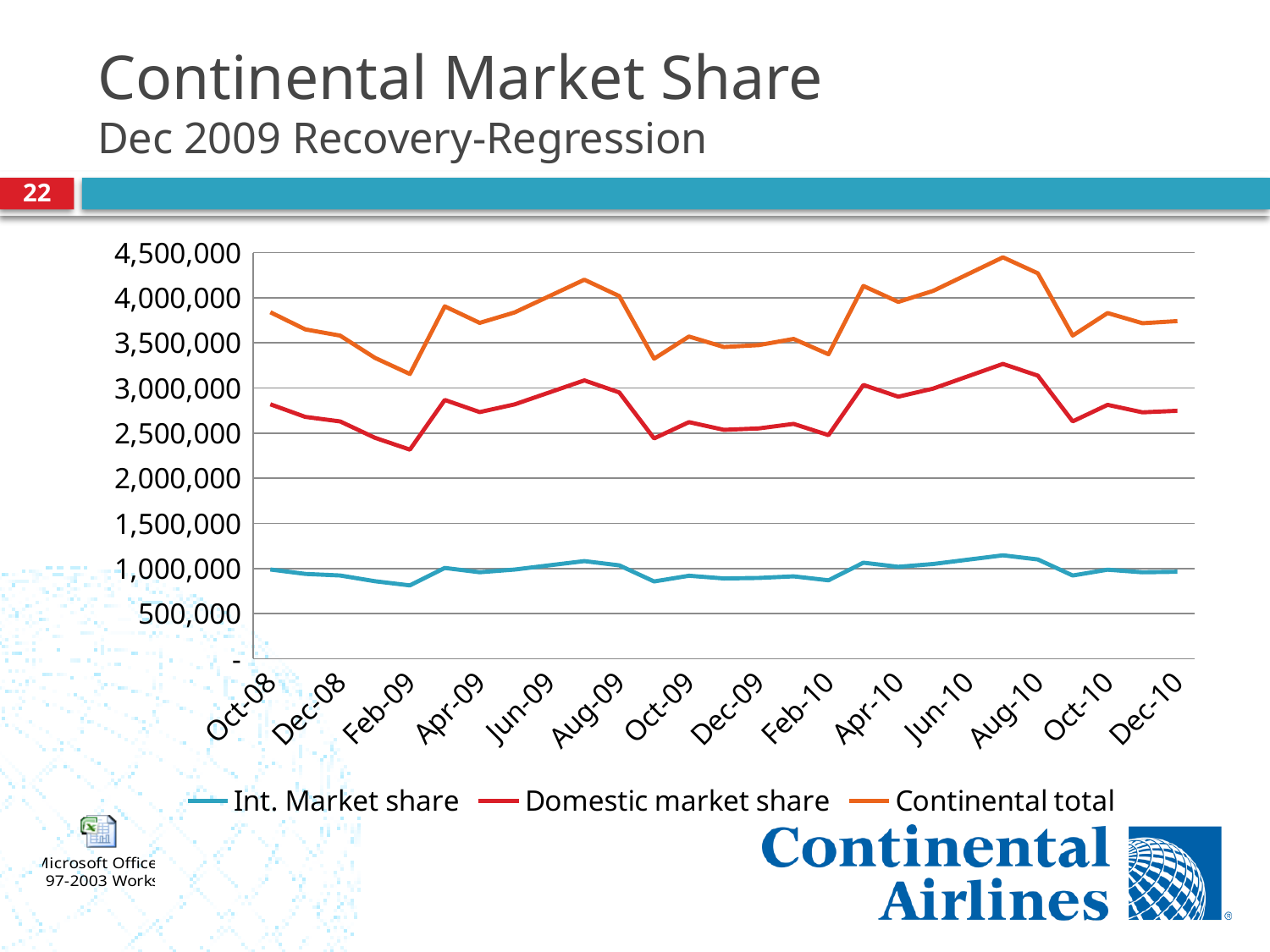
Which series is drawn in orange? Continental total In which month does the Continental total series reach its lowest value? Feb-09 In which month does the Continental total series reach its highest value? Jul-10 How many month labels are shown along the x axis? 14 Is the Int. Market share value for Feb-09 greater or less than 1,000,000? less What kind of chart is shown on the slide? line chart Is the Continental total value for Feb-09 greater or less than 3,500,000? less What is the title of the chart slide? Continental Market Share Is the Continental total value for Aug-10 greater or less than 4,000,000? greater How many series does the legend list? 3 Which is larger for the Continental total series: the value for Aug-09 or the value for Aug-10? Aug-10 In which month does the Domestic market share series reach its lowest value? Feb-09